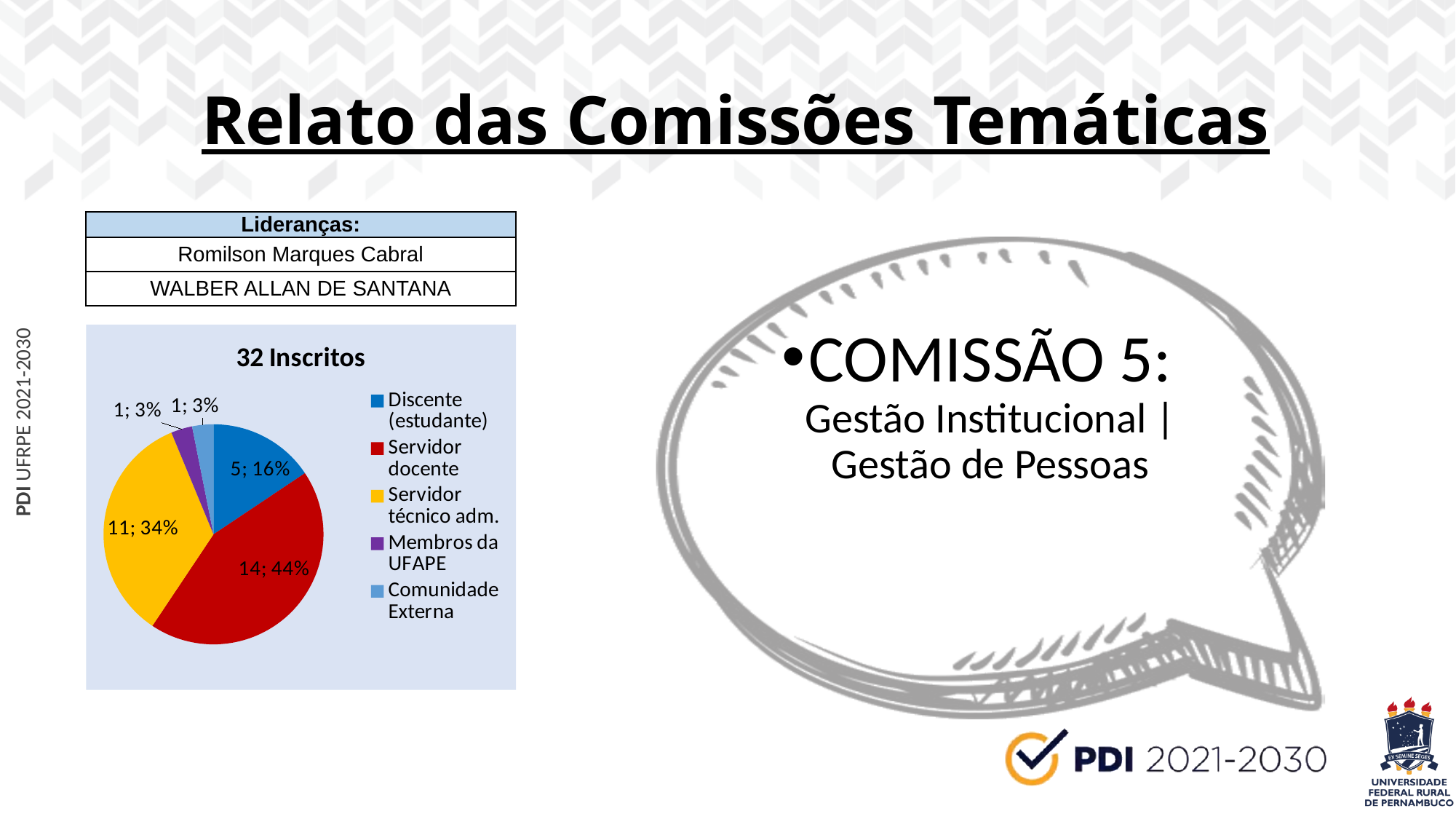
What is the title of the pie chart? 32 Inscritos Which colour represents Comunidade Externa in the pie chart? light blue What percentage share does Membros da UFAPE have? 3% What is the difference between the Servidor docente count and the Servidor técnico adm. count? 3 Which is larger, the Discente (estudante) slice or the Servidor técnico adm. slice? Servidor técnico adm. What is the count for Discente (estudante)? 5 What type of chart is shown on the slide? pie chart What percentage of the pie does Servidor técnico adm. represent? 34% How many slices does the pie chart have? 5 Which category has the largest slice of the pie? Servidor docente How many entries does the legend of the pie chart list? 5 How many inscritos are in the Servidor docente category? 14